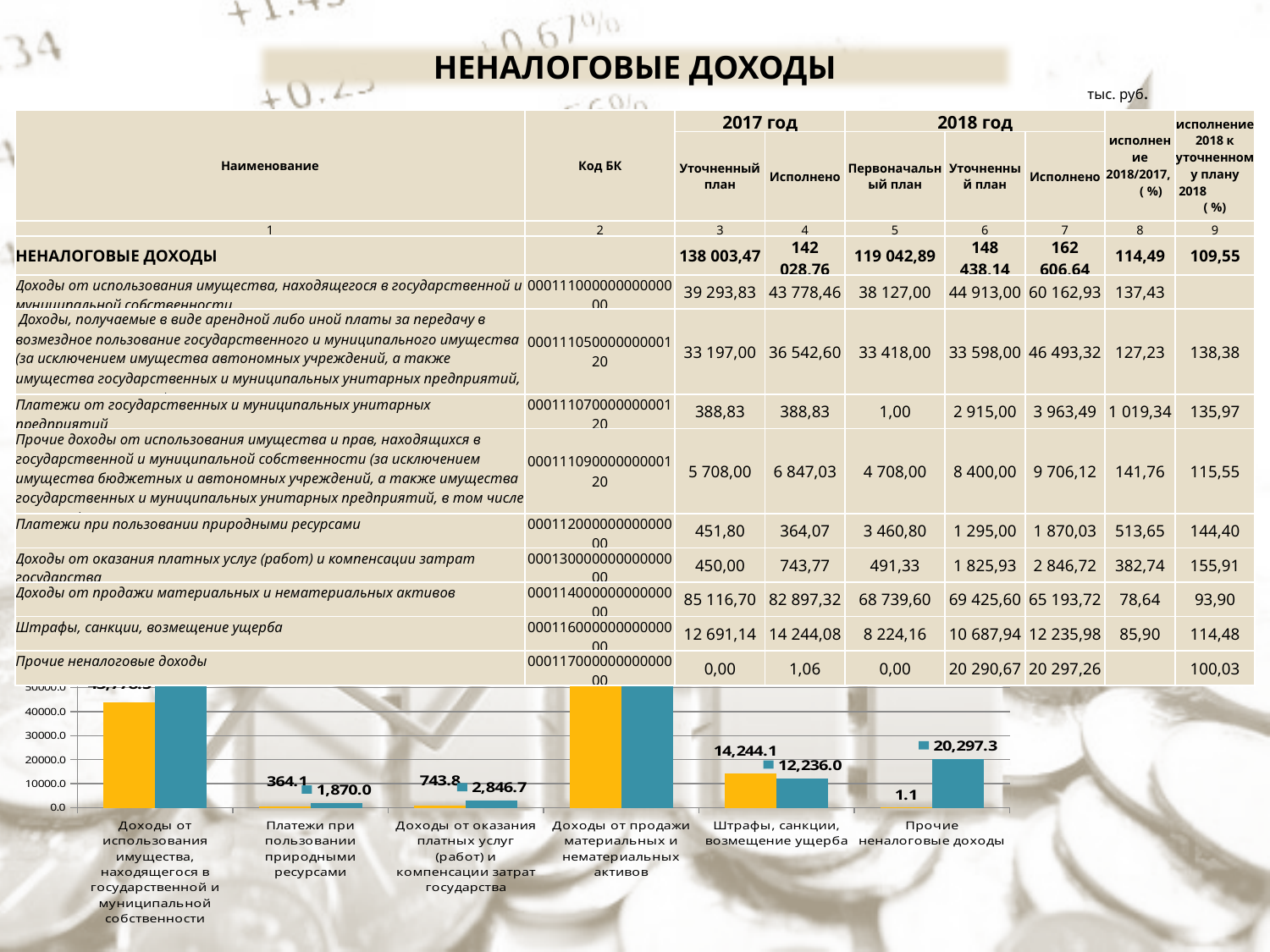
How many bars are plotted for each category in the bar chart? 2 What type of chart is shown at the bottom of the slide? bar chart In the bar chart, which category has the lowest yellow bar? Прочие неналоговые доходы In the bar chart, what is the difference between the teal and yellow bars for 'Доходы от оказания платных услуг (работ) и компенсации затрат государства'? 2,102.9 In the bar chart, what is the value of the teal bar for 'Доходы от оказания платных услуг (работ) и компенсации затрат государства'? 2,846.7 In the bar chart, which bar is larger for 'Штрафы, санкции, возмещение ущерба', the yellow one or the teal one? the yellow one How many categories are shown on the x axis of the bar chart? 6 In the bar chart, what is the difference between the teal and yellow bars for 'Прочие неналоговые доходы'? 20,296.2 In the bar chart, what is the value of the yellow bar for 'Штрафы, санкции, возмещение ущерба'? 14,244.1 In the bar chart, what is the value of the teal bar for 'Прочие неналоговые доходы'? 20,297.3 In the bar chart, what is the value of the yellow bar for 'Платежи при пользовании природными ресурсами'? 364.1 In the bar chart, what is the value of the teal bar for 'Платежи при пользовании природными ресурсами'? 1,870.0